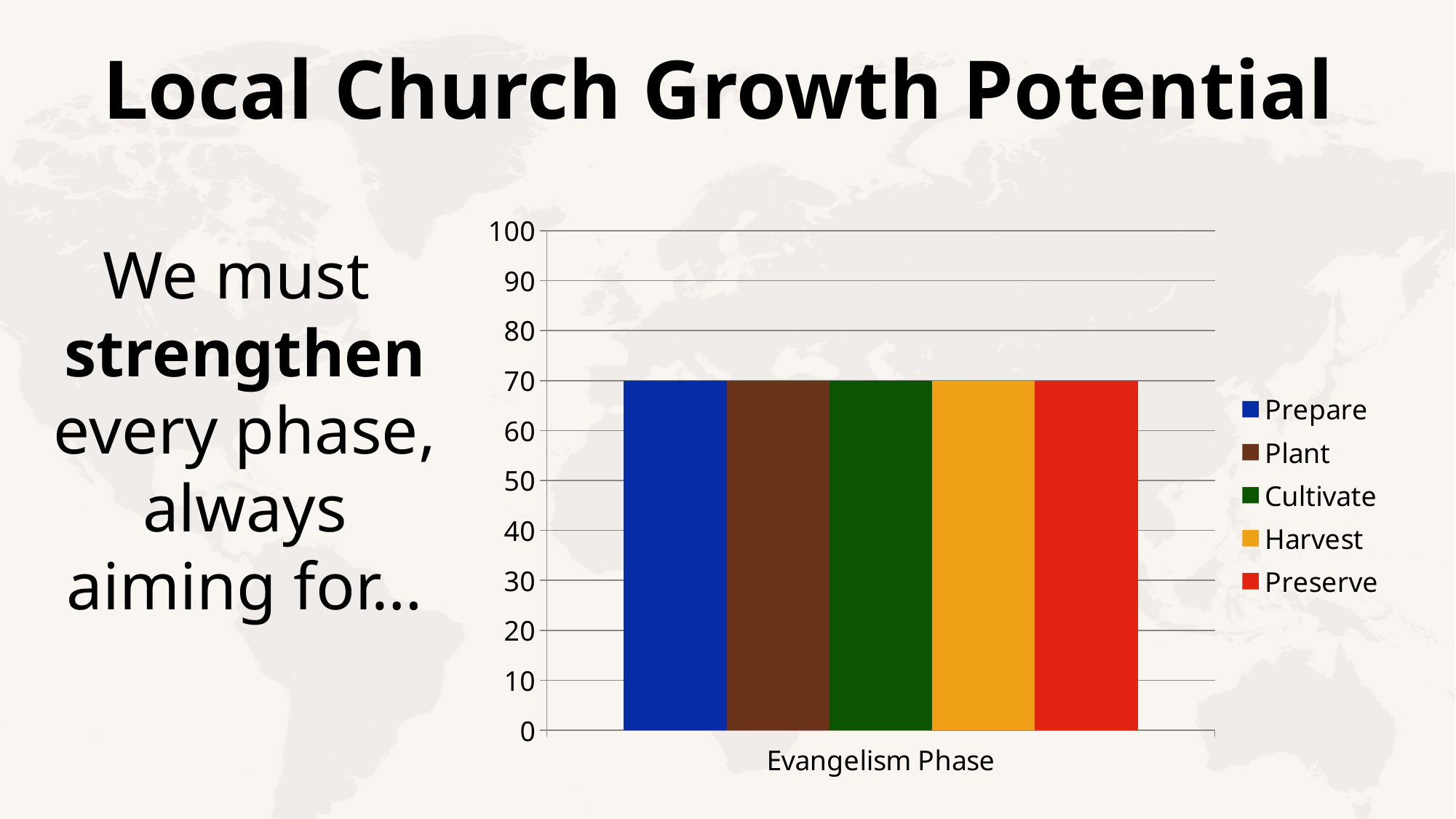
What is the value of the Cultivate bar? 70 Is the value for Preserve greater or less than 90? less What is the value of the Prepare bar? 70 What is the difference between the Prepare and Preserve values? 0 What is the label on the x axis of the chart? Evangelism Phase What kind of chart is shown on the slide? bar chart How many series does the legend list? 5 What is the value of the Harvest bar? 70 Is the value for Harvest greater or less than 50? greater What is the value of the Preserve bar? 70 Which legend entry is shown in green? Cultivate What is the value of the Plant bar? 70